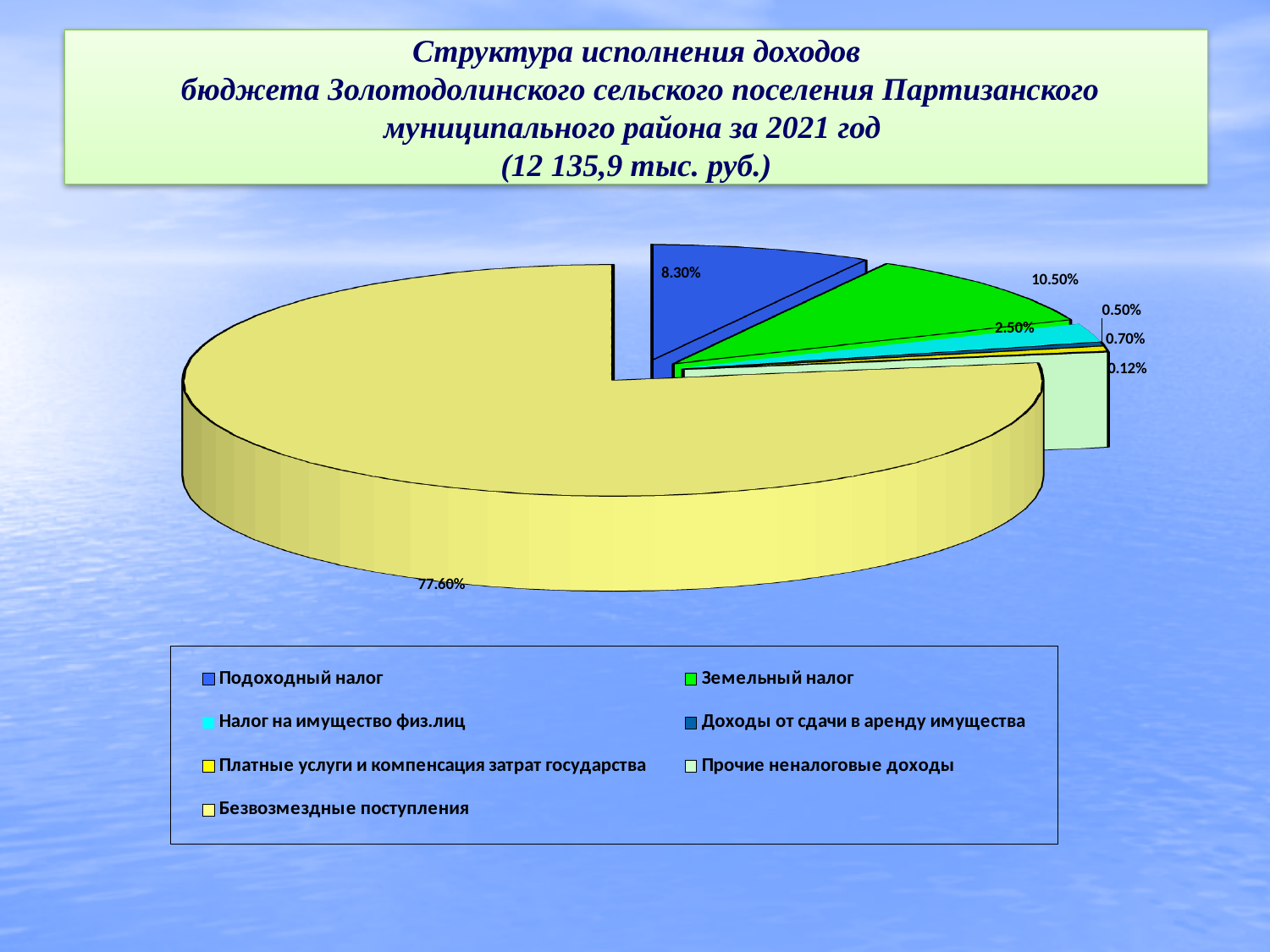
How many categories does the legend list? 7 What is the smallest percentage label shown on the pie? 0.12% What kind of chart is shown on the slide? pie chart What colour is the slice for Подоходный налог? blue What share of the pie does Налог на имущество физ.лиц have? 2.50% What share of the pie does Подоходный налог have? 8.30% Which category has the largest share of the pie? Безвозмездные поступления What share of the pie does Безвозмездные поступления have? 77.60% Which is larger, the share for Земельный налог or the share for Подоходный налог? Земельный налог What share of the pie does Земельный налог have? 10.50% What is the difference between the shares for Земельный налог and Подоходный налог? 2.20% What total amount of revenue is given in the chart title? 12 135,9 тыс. руб.